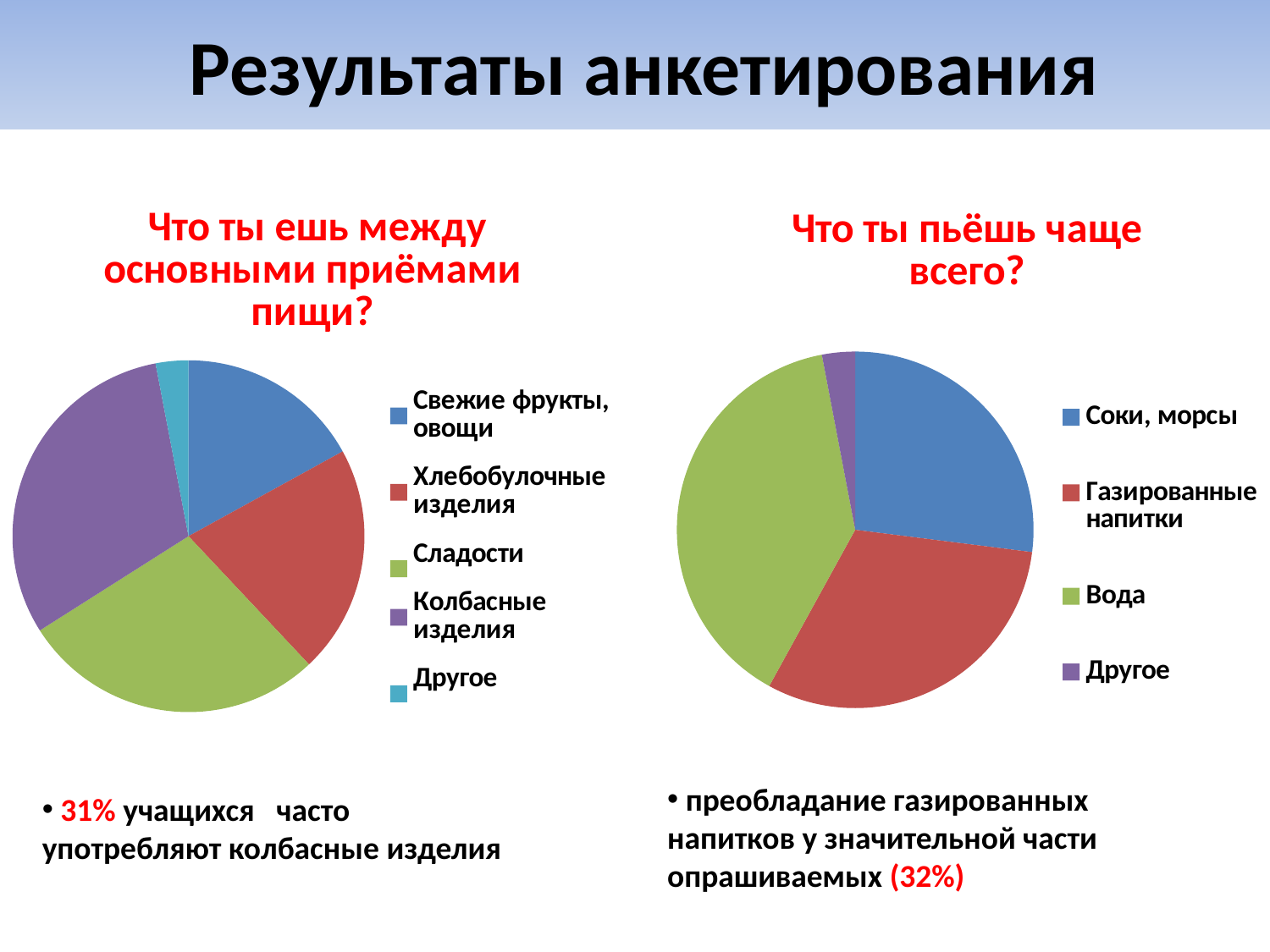
In the 'Что ты пьёшь чаще всего?' chart, what colour is the slice for Вода? green According to the slide, what share of respondents most often drink газированные напитки? 32% In the 'Что ты ешь между основными приёмами пищи?' chart, which category has the smallest slice? Другое How many categories does the legend of the 'Что ты пьёшь чаще всего?' chart list? 4 According to the slide, what share of students often eat колбасные изделия? 31% In the 'Что ты пьёшь чаще всего?' chart, which slice is larger: Соки, морсы or Другое? Соки, морсы In the 'Что ты ешь между основными приёмами пищи?' chart, which category has the largest slice? Колбасные изделия In the 'Что ты ешь между основными приёмами пищи?' chart, which slice is larger: Колбасные изделия or Свежие фрукты, овощи? Колбасные изделия In the 'Что ты пьёшь чаще всего?' chart, which category has the smallest slice? Другое How many categories does the legend of the 'Что ты ешь между основными приёмами пищи?' chart list? 5 What kind of chart is used for 'Что ты ешь между основными приёмами пищи?'? pie chart What is the title of the chart on the left side of the slide? Что ты ешь между основными приёмами пищи?